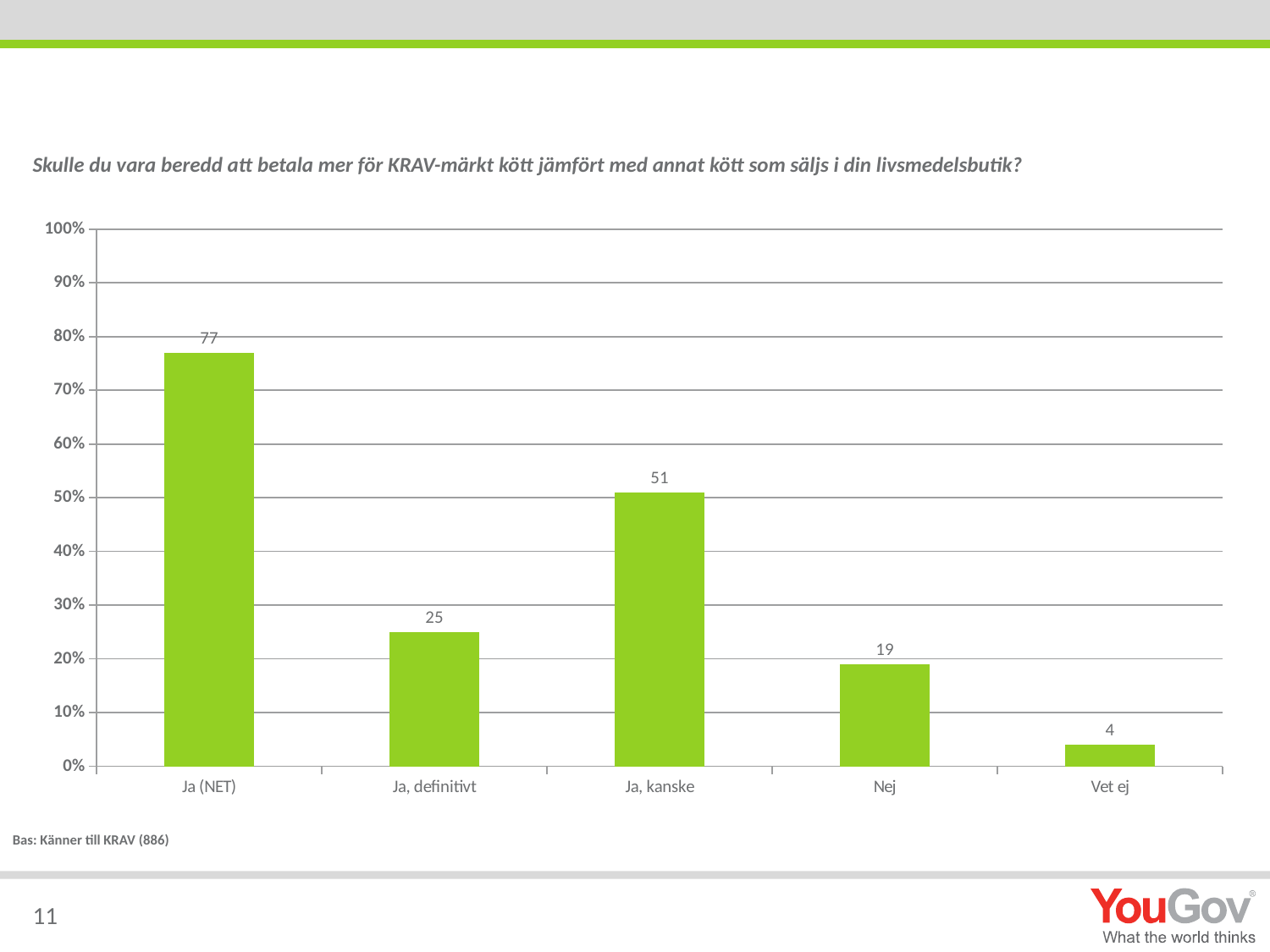
How many categories are shown on the x axis? 5 What is the value for Vet ej? 4 Which category has the highest value? Ja (NET) What is the base stated below the chart? Känner till KRAV (886) What is the value for Ja, kanske? 51 What is the value for Nej? 19 Which is larger, the value for Ja, definitivt or the value for Nej? Ja, definitivt What kind of chart is shown on the slide? bar chart What is the difference between the values for Ja, kanske and Ja, definitivt? 26 Which category has the lowest value? Vet ej Is the value for Ja, kanske greater or less than 40%? greater What is the value for Ja (NET)? 77